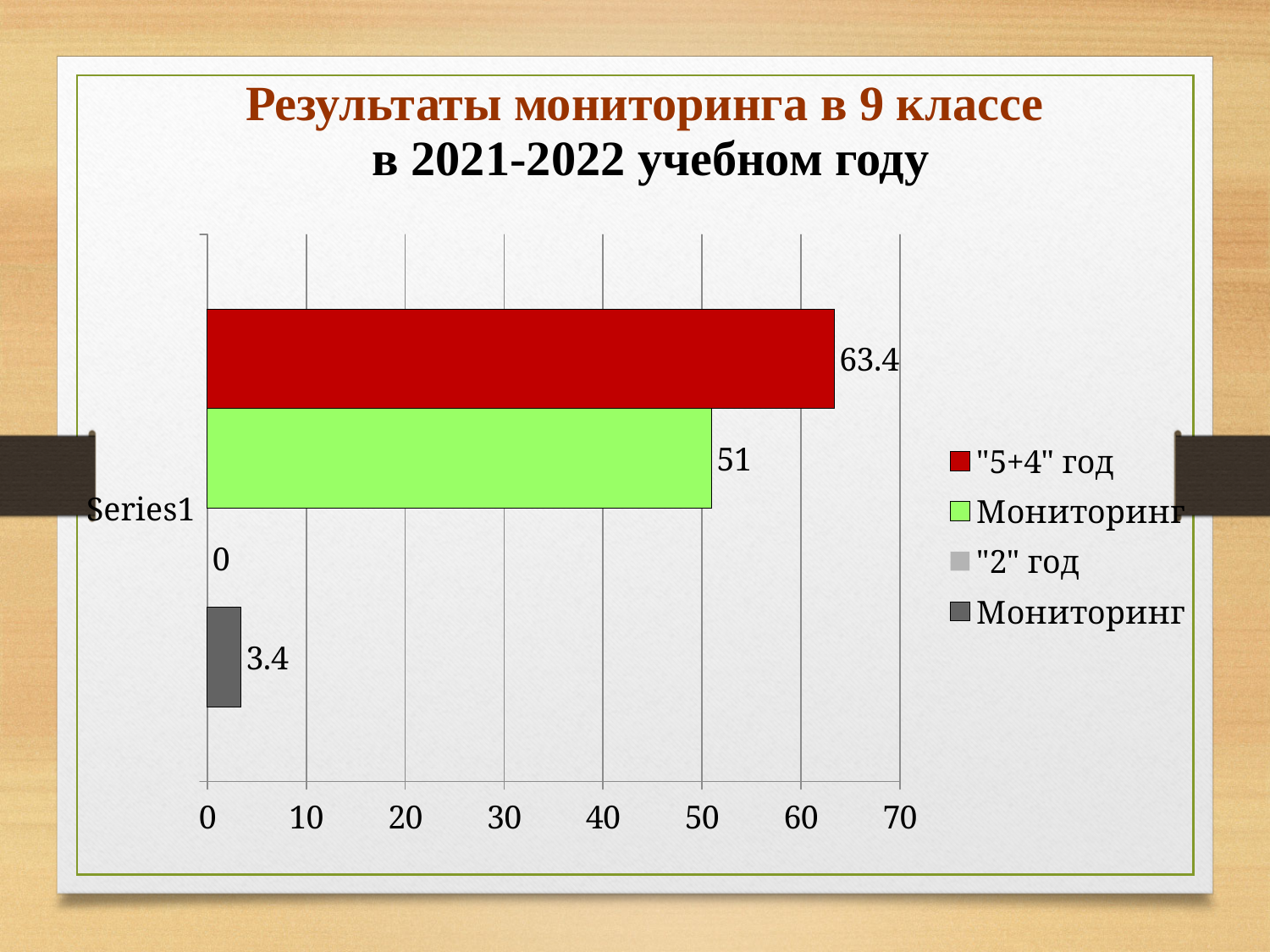
What is the difference between the "5+4" год value and the light green Мониторинг value? 12.4 What is the value of the dark gray Мониторинг bar? 3.4 How many series does the legend list? 4 What kind of chart is shown on the slide? bar chart Which series has the lowest value? "2" год Is the value of the red "5+4" год bar greater or less than 60? greater What is the value of the red "5+4" год bar? 63.4 What is the title of the slide? Результаты мониторинга в 9 классе в 2021-2022 учебном году What is the value of the light green Мониторинг bar? 51 What is the value of the "2" год series? 0 Which series has the highest value? "5+4" год Which is larger: the "5+4" год value or the light green Мониторинг value? "5+4" год